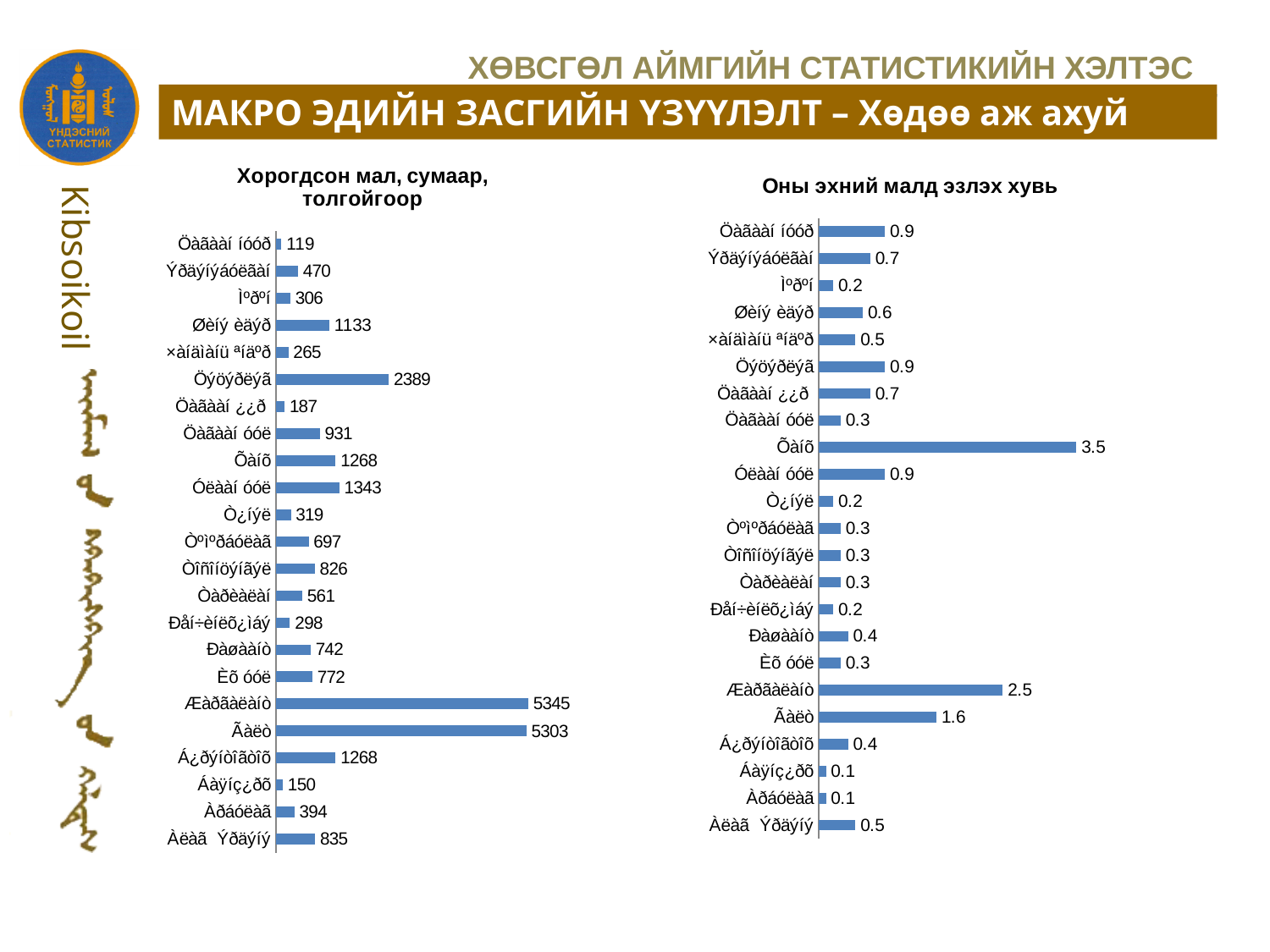
How many categories are plotted in the right chart "Оны эхний малд эзлэх хувь"? 23 In the left chart "Хорогдсон мал, сумаар, толгойгоор", what is the highest value shown? 5345 In the right chart "Оны эхний малд эзлэх хувь", what is the lowest value shown? 0.1 In the left chart "Хорогдсон мал, сумаар, толгойгоор", what is the value of the bottom-most category? 835 How many categories are plotted in the left chart "Хорогдсон мал, сумаар, толгойгоор"? 23 What is the title of the right chart on the slide? Оны эхний малд эзлэх хувь In the right chart "Оны эхний малд эзлэх хувь", what is the value of the top-most category? 0.9 In the left chart "Хорогдсон мал, сумаар, толгойгоор", what is the lowest value shown? 119 In the left chart "Хорогдсон мал, сумаар, толгойгоор", what is the difference between the two largest values, 5345 and 5303? 42 What type of chart is the left chart titled "Хорогдсон мал, сумаар, толгойгоор"? bar chart In the right chart "Оны эхний малд эзлэх хувь", what is the highest value shown? 3.5 What type of chart is the right chart titled "Оны эхний малд эзлэх хувь"? bar chart